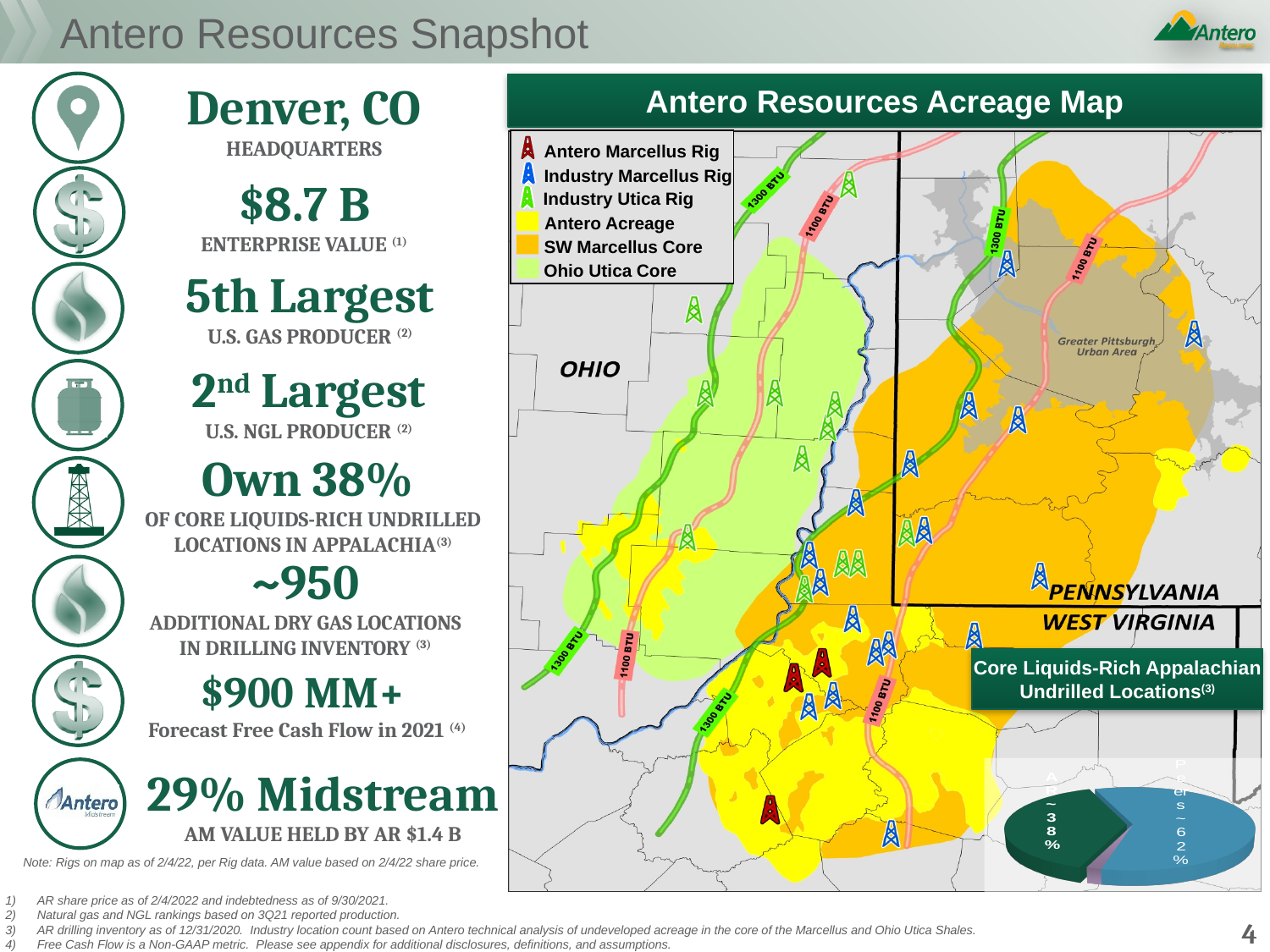
What is the title of the pie chart on the slide? Core Liquids-Rich Appalachian Undrilled Locations In the Core Liquids-Rich Appalachian Undrilled Locations pie chart, which slice is the largest? Peers What kind of chart is the Core Liquids-Rich Appalachian Undrilled Locations chart? Pie chart In the Core Liquids-Rich Appalachian Undrilled Locations pie chart, which slice is the smallest? AR In the Core Liquids-Rich Appalachian Undrilled Locations pie chart, which is larger, the AR slice or the Peers slice? Peers In the Core Liquids-Rich Appalachian Undrilled Locations pie chart, what colour is the AR slice? Dark green